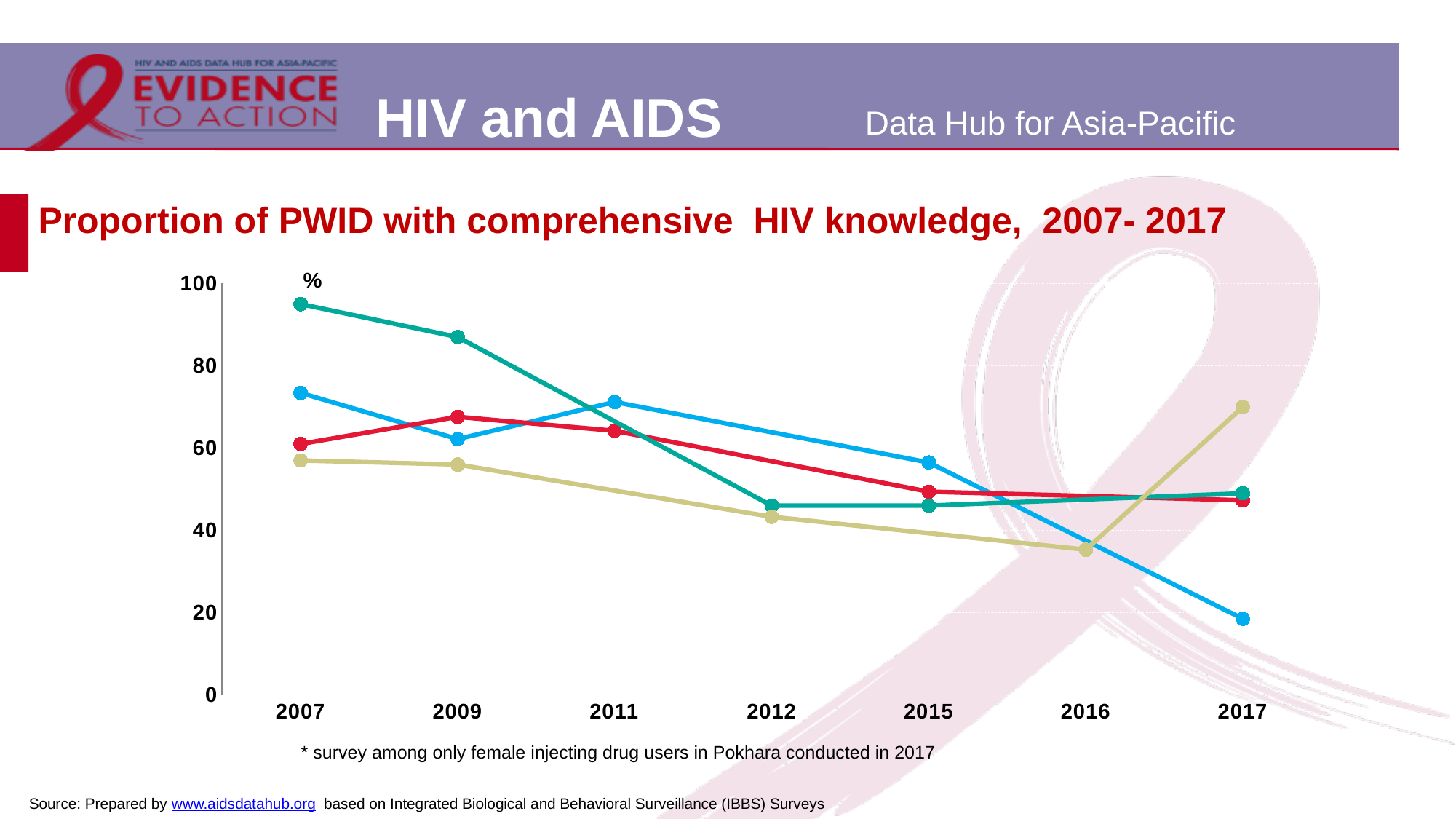
Is the value of the yellow line in 2016 greater or less than 40? less How many years are marked on the x axis of the chart? 7 Does the yellow line rise or fall between 2016 and 2017? rise Is the value of the red line in 2009 greater or less than 60? greater In which year does the green line reach its highest value? 2007 What is the title of the chart? Proportion of PWID with comprehensive HIV knowledge, 2007- 2017 What kind of chart is shown on the slide? line chart Is the value of the blue line in 2017 greater or less than 40? less In 2007, which line has the larger value, the green line or the yellow line? green line In which year does the blue line reach its lowest value? 2017 Does the blue line rise or fall overall from 2007 to 2017? fall